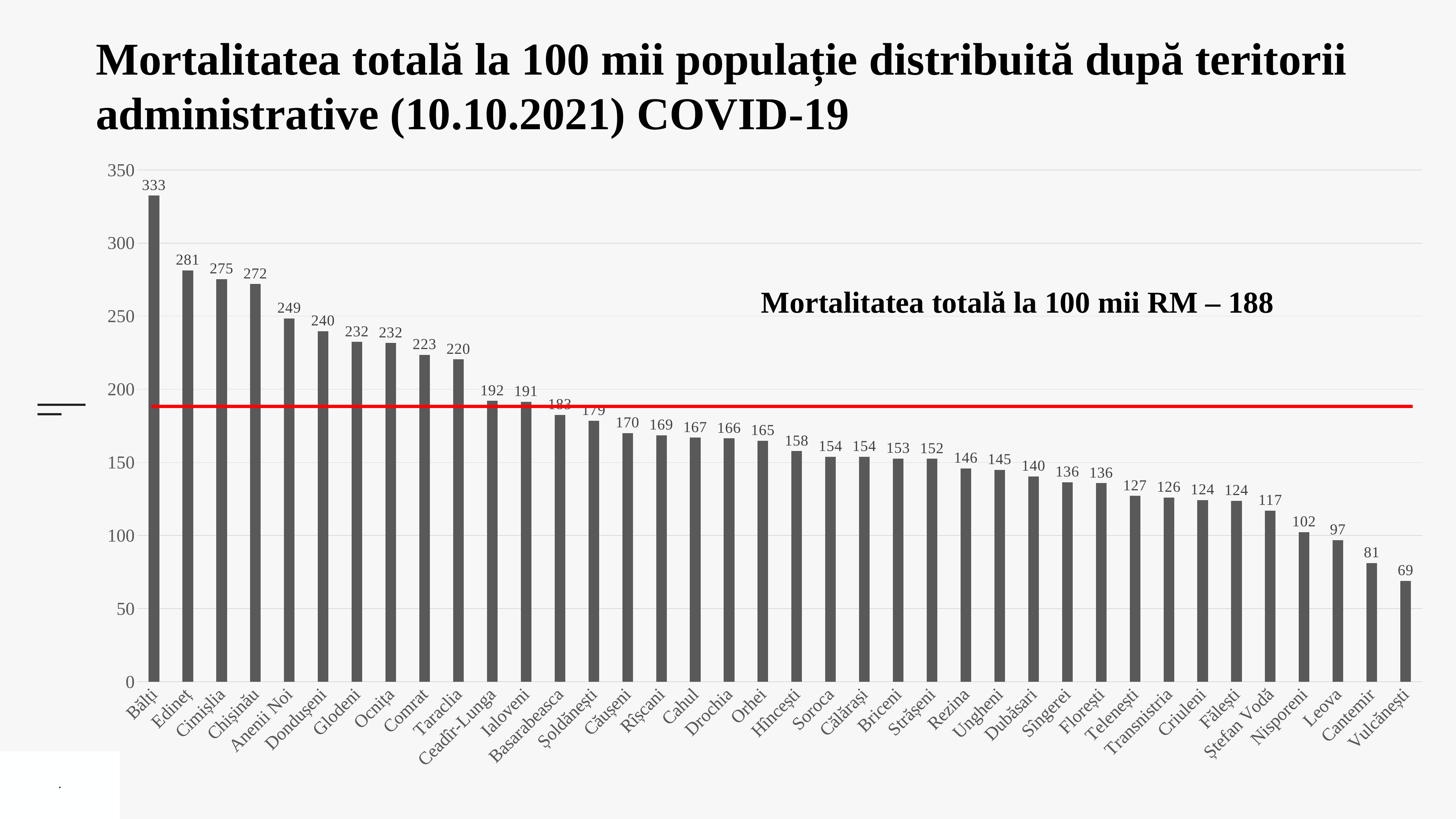
What kind of chart is shown on the slide? Bar chart What is the value for Chișinău? 272 What is the value for Bălți? 333 How many territories are shown on the chart? 38 What value does the red horizontal line on the chart represent, according to the label? 188 Which territory has the lowest value? Vulcănești Do the values rise or fall from left to right along the x axis? Fall Which has a larger value, Comrat or Taraclia? Comrat What is the value for Vulcănești? 69 Which territory has the highest value? Bălți What is the value for Cahul? 167 What is the difference between the values for Bălți and Edineț? 52